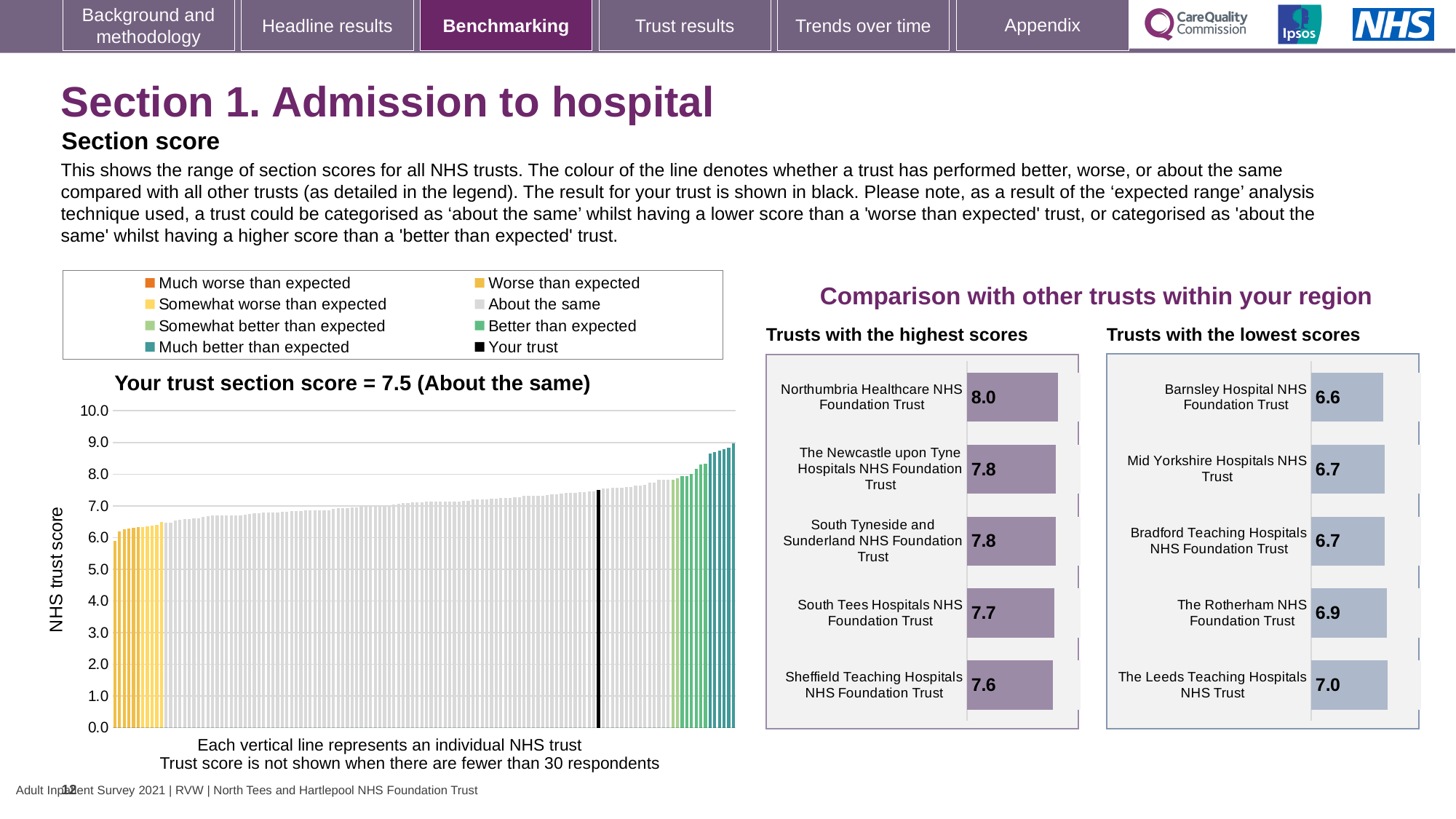
In the 'Trusts with the highest scores' chart, what is the score for Northumbria Healthcare NHS Foundation Trust? 8.0 In the 'Your trust section score' chart, what is the section score for your trust? 7.5 In the 'Your trust section score' chart, how many entries does the legend list? 8 In the 'Trusts with the highest scores' chart, how many trusts are shown? 5 In the 'Trusts with the highest scores' chart, which trust has the highest score? Northumbria Healthcare NHS Foundation Trust In the 'Your trust section score' chart, do the trust scores rise or fall from left to right along the x axis? Rise In the 'Trusts with the lowest scores' chart, which trust has the lowest score? Barnsley Hospital NHS Foundation Trust In the 'Your trust section score' chart, what is the label on the vertical axis? NHS trust score In the 'Trusts with the lowest scores' chart, which has the higher score, The Rotherham NHS Foundation Trust or The Leeds Teaching Hospitals NHS Trust? The Leeds Teaching Hospitals NHS Trust In the 'Trusts with the highest scores' chart, what is the difference between the scores of Northumbria Healthcare NHS Foundation Trust and Sheffield Teaching Hospitals NHS Foundation Trust? 0.4 In the 'Trusts with the lowest scores' chart, what is the score for Barnsley Hospital NHS Foundation Trust? 6.6 In the 'Your trust section score' chart, what kind of chart is shown? Bar chart